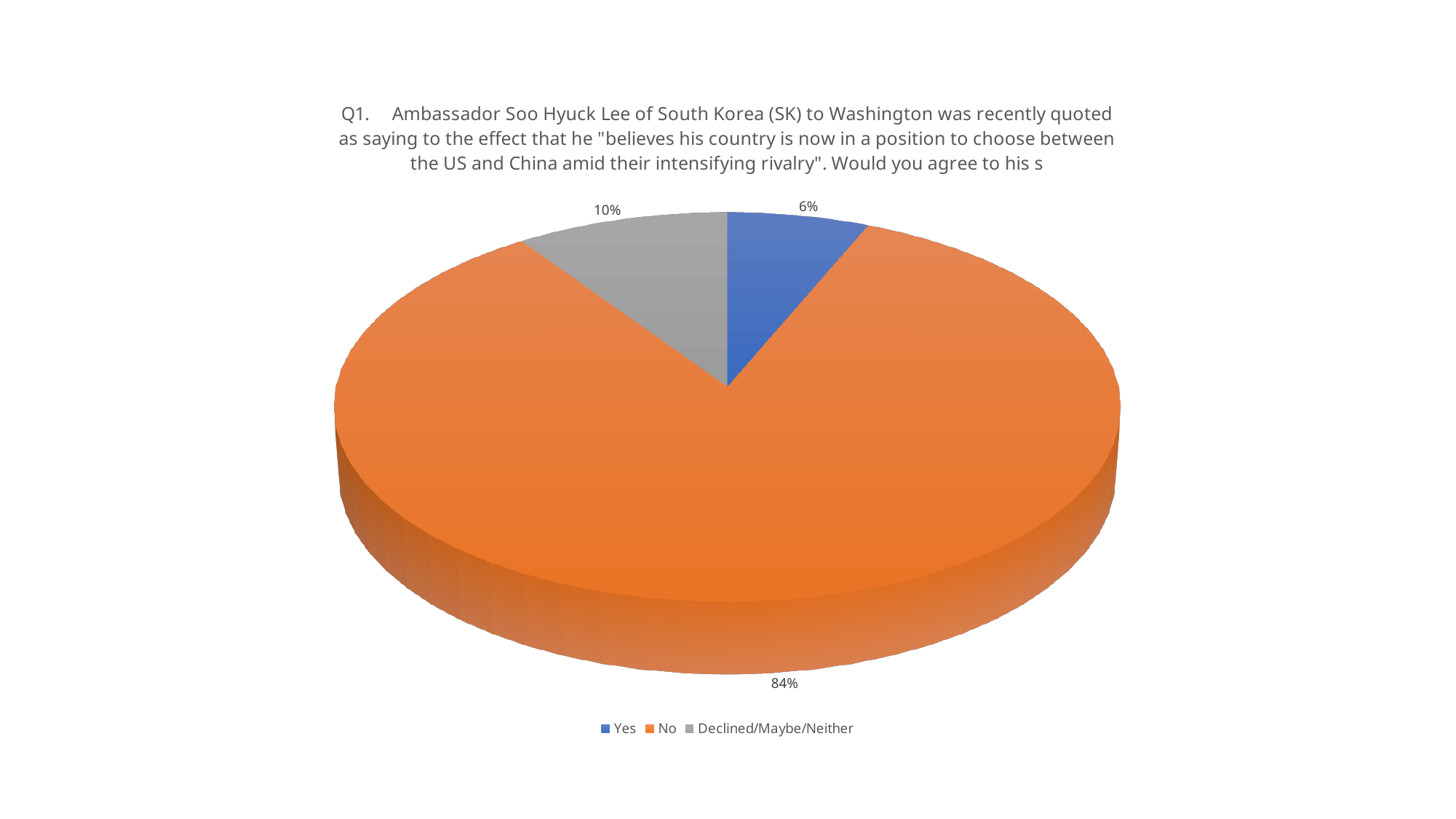
What is the difference in percentage points between the "Declined/Maybe/Neither" slice and the "Yes" slice? 4 What share of the pie is labelled "No"? 84% How many categories does the pie chart have? 3 What colour is the "No" slice of the pie? Orange What share of the pie is labelled "Yes"? 6% What share of the pie is labelled "Declined/Maybe/Neither"? 10% Which legend entry is shown in grey? Declined/Maybe/Neither Which category has the smallest slice of the pie? Yes What is the difference in percentage points between the "No" slice and the "Yes" slice? 78 Which slice is larger, "Yes" or "Declined/Maybe/Neither"? Declined/Maybe/Neither Which category has the largest slice of the pie? No What kind of chart is shown on the slide? Pie chart